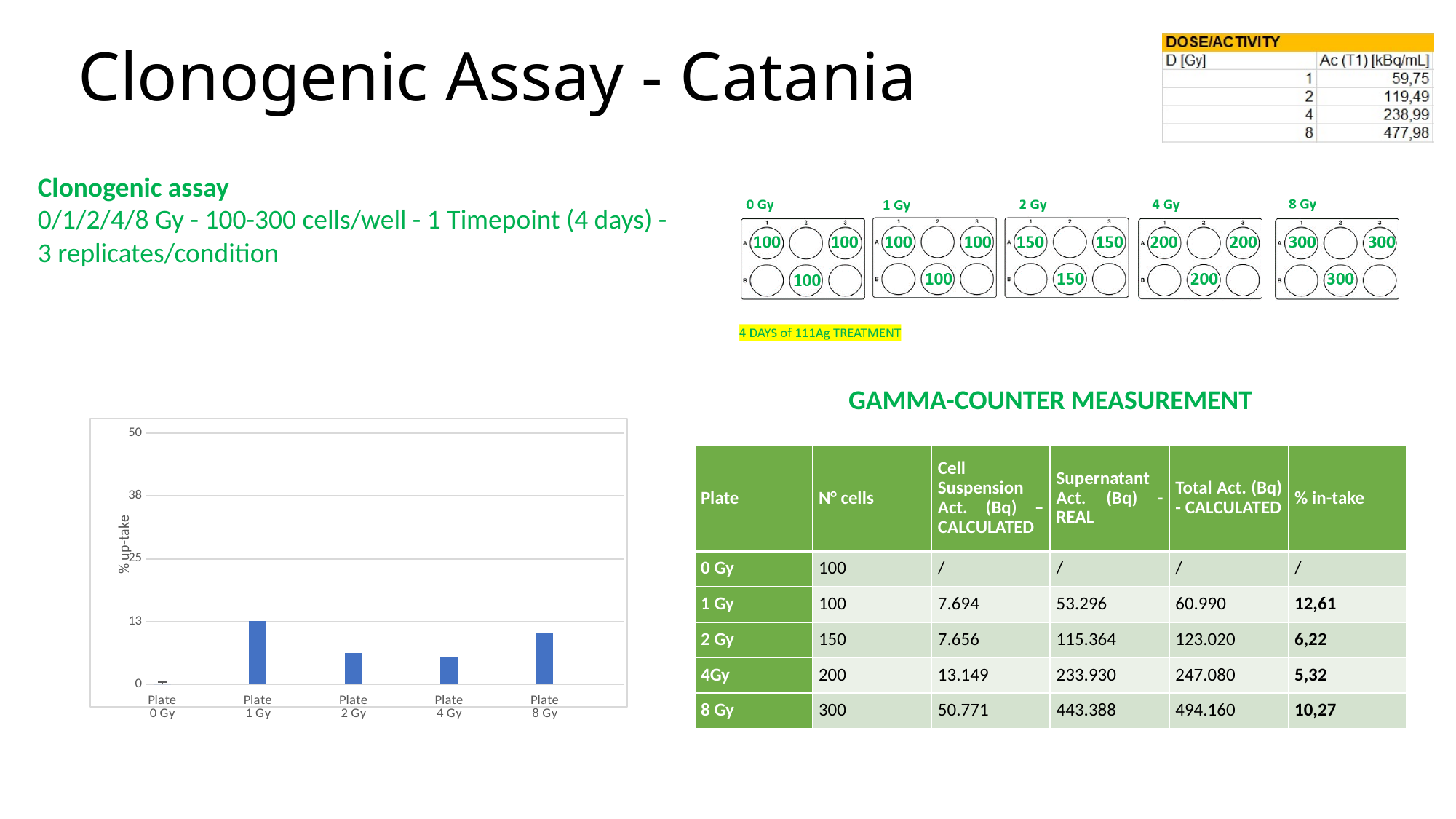
What is the label of the y axis of the bar chart? % up-take In the bar chart, which has the larger % up-take, Plate 1 Gy or Plate 2 Gy? Plate 1 Gy How many plates (categories) are shown on the x axis of the bar chart? 5 In the bar chart, is the % up-take for Plate 4 Gy greater or less than 13? less In the bar chart, is the % up-take for Plate 1 Gy greater or less than 25? less In the bar chart, which has the larger % up-take, Plate 8 Gy or Plate 4 Gy? Plate 8 Gy Which plate has the lowest % up-take in the bar chart? Plate 0 Gy In the bar chart, is the % up-take for Plate 2 Gy greater or less than 13? less Which plate has the highest % up-take in the bar chart? Plate 1 Gy What is the highest tick value shown on the y axis of the bar chart? 50 What kind of chart is shown on the slide? bar chart